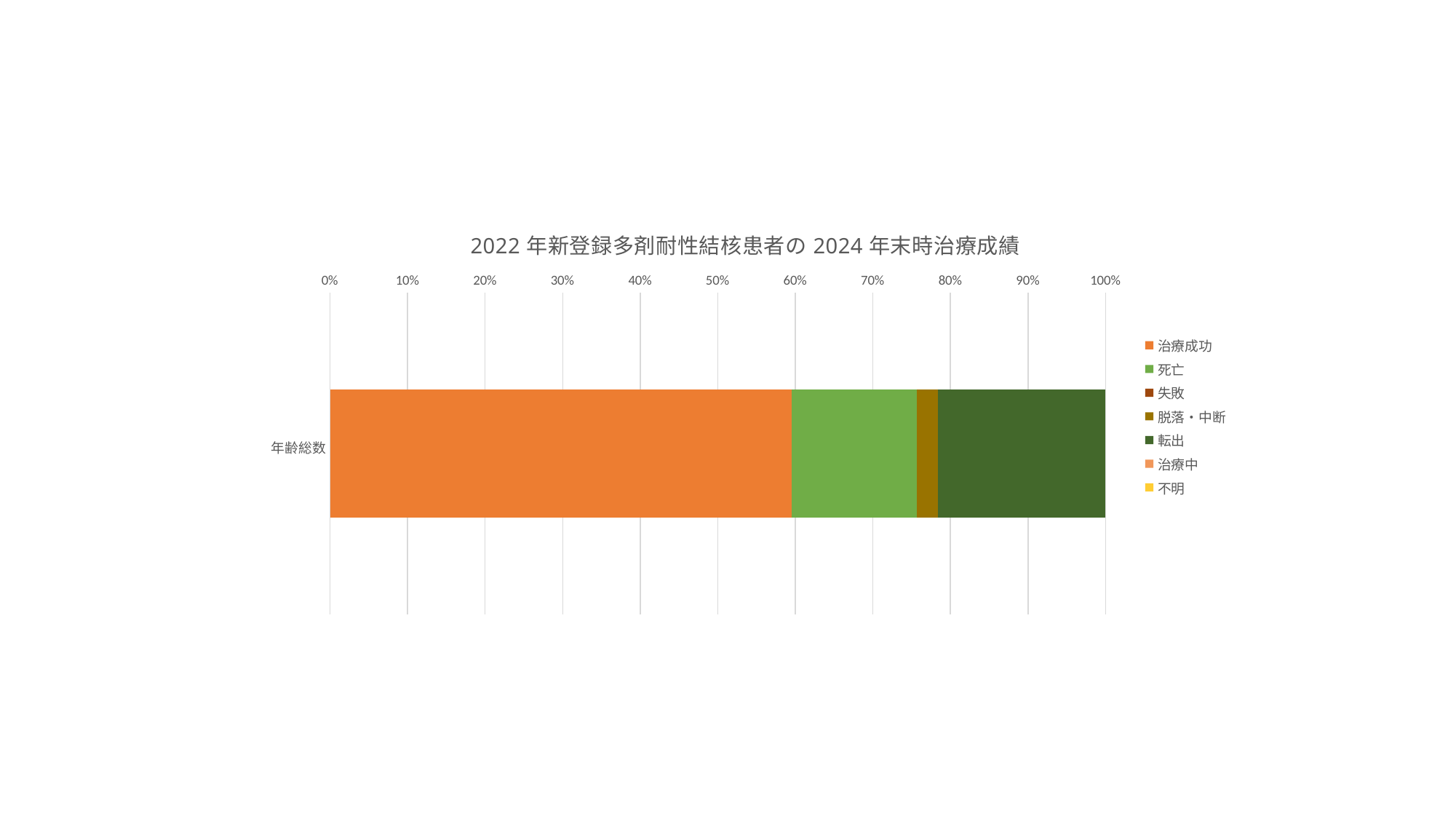
What kind of chart is shown on the slide? Stacked bar chart How many categories are plotted on the vertical axis? 1 Which series takes up the largest share of the bar for 年齢総数? 治療成功 Which segment is larger in the bar, 死亡 or 転出? 転出 At what value on the horizontal axis does the stacked bar for 年齢総数 end? 100% Is the share for 治療成功 greater or less than 50%? greater What is the title of the chart? 2022 年新登録多剤耐性結核患者の 2024 年末時治療成績 Which segment is larger in the bar, 治療成功 or 転出? 治療成功 Is the share for 転出 greater or less than 30%? less How many series does the legend list? 7 Is the share for 死亡 greater or less than 20%? less What is the label of the single category on the vertical axis? 年齢総数